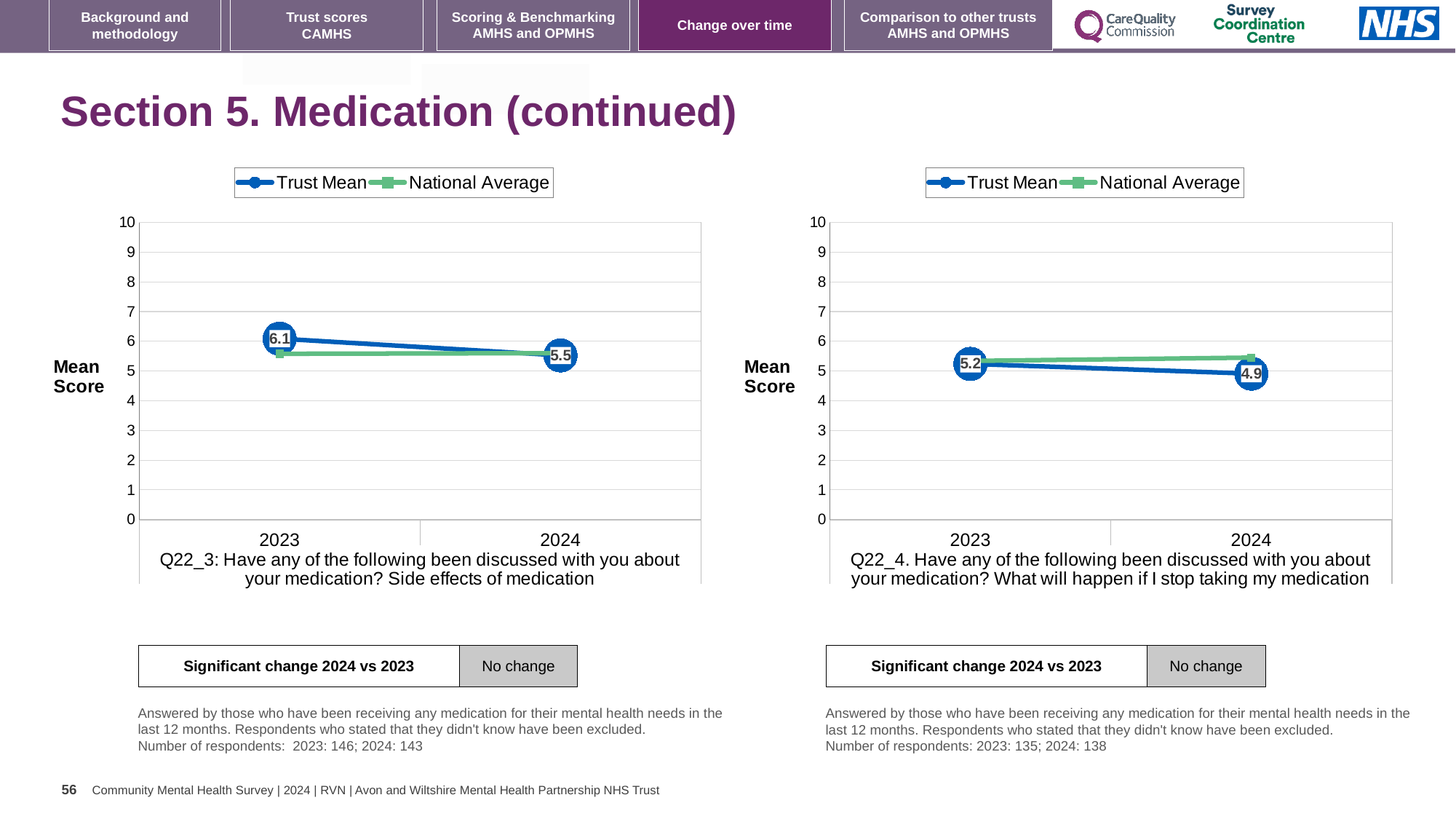
In the right chart (Q22_4), what is the Trust Mean for 2024? 4.9 In the left chart (Q22_3), what is the Trust Mean for 2023? 6.1 In the right chart (Q22_4), what is the Trust Mean for 2023? 5.2 In the left chart (Q22_3), by how much did the Trust Mean change from 2023 to 2024? 0.6 In the left chart (Q22_3), does the Trust Mean rise or fall from 2023 to 2024? fall In the right chart (Q22_4), is the National Average for 2024 greater or less than 6? less How many years are shown on the x axis of the left chart (Q22_3)? 2 In the left chart (Q22_3), what is the Trust Mean for 2024? 5.5 In the right chart (Q22_4), does the Trust Mean rise or fall from 2023 to 2024? fall What kind of chart is the left chart (Q22_3)? line chart In the right chart (Q22_4), what is the difference between the Trust Mean in 2023 and 2024? 0.3 How many series does the legend of the right chart (Q22_4) list? 2